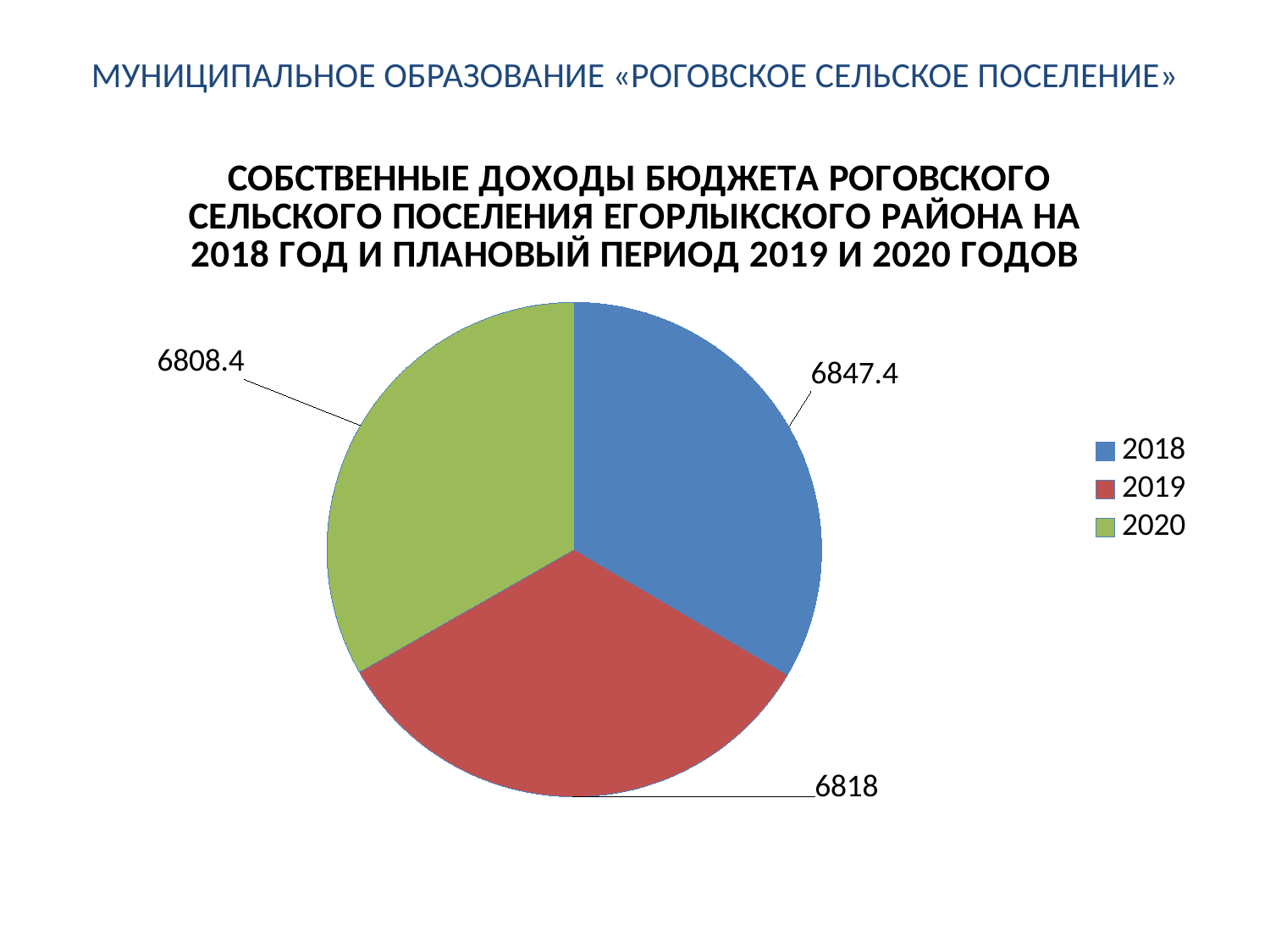
How many slices does the pie chart have? 3 Which is larger, the value for 2019 or the value for 2020? 2019 What is the value for 2019 in the pie chart? 6818 What is the value for 2018 in the pie chart? 6847.4 What colour is the slice for 2019? Red What is the value for 2020 in the pie chart? 6808.4 Which year has the lowest value in the pie chart? 2020 What is the difference between the values for 2018 and 2020? 39 How many entries does the legend list? 3 Which year has the highest value in the pie chart? 2018 What is the difference between the values for 2018 and 2019? 29.4 What type of chart is shown on the slide? Pie chart